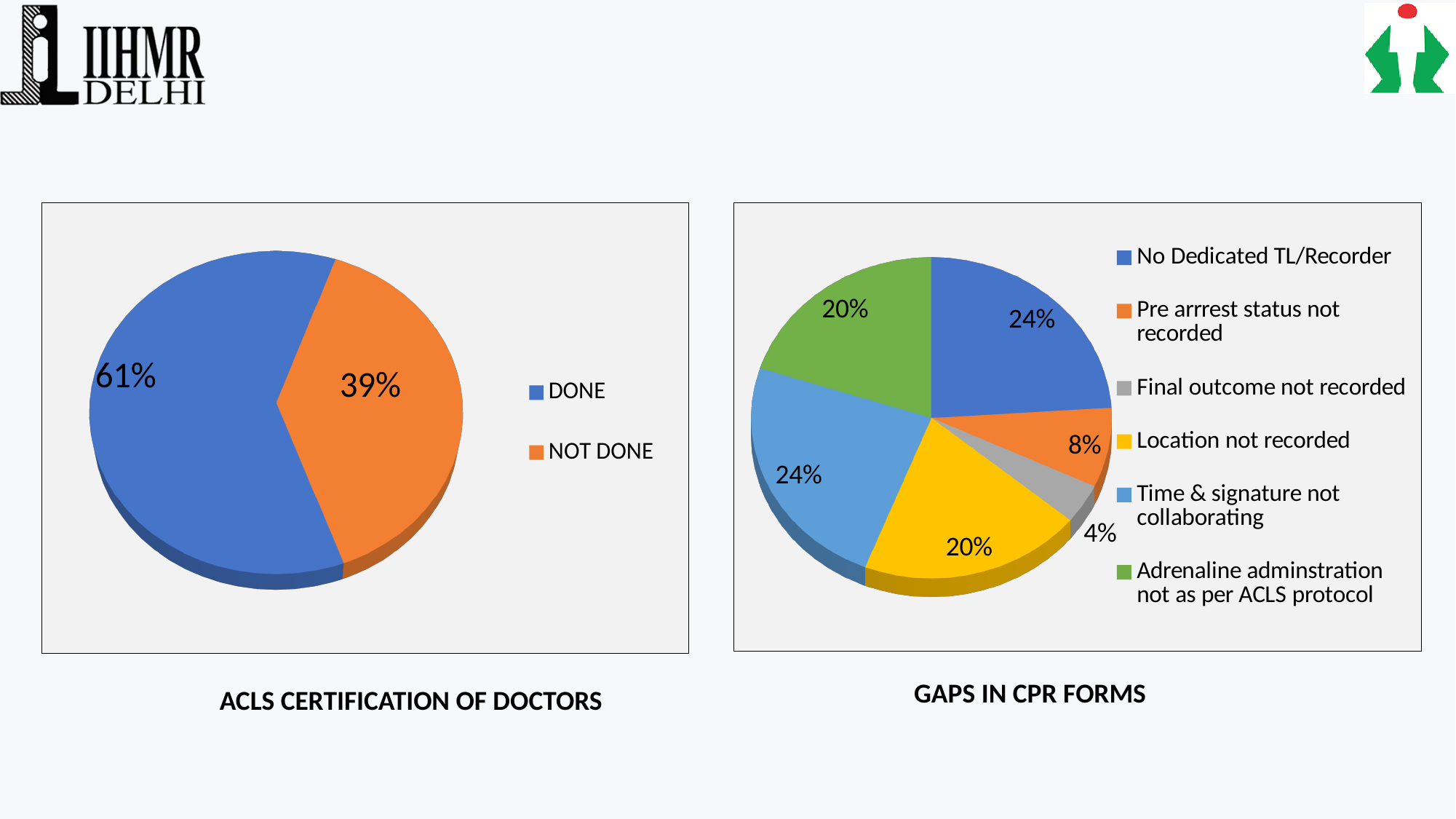
In the Gaps in CPR Forms chart, which gap has the smallest share? Final outcome not recorded In the Gaps in CPR Forms chart, what colour is the slice for Location not recorded? Yellow What kind of chart is the ACLS Certification of Doctors chart? Pie chart In the Gaps in CPR Forms chart, what percentage is Location not recorded? 20% In the ACLS Certification of Doctors chart, what share of doctors have certification DONE? 61% In the ACLS Certification of Doctors chart, what percentage is NOT DONE? 39% In the ACLS Certification of Doctors chart, what is the difference in percentage points between DONE and NOT DONE? 22 In the Gaps in CPR Forms chart, what percentage is Pre arrest status not recorded? 8% In the ACLS Certification of Doctors chart, which category has the larger share, DONE or NOT DONE? DONE In the Gaps in CPR Forms chart, what percentage is Final outcome not recorded? 4% In the Gaps in CPR Forms chart, which is larger: No Dedicated TL/Recorder or Pre arrest status not recorded? No Dedicated TL/Recorder How many categories does the Gaps in CPR Forms chart show? 6